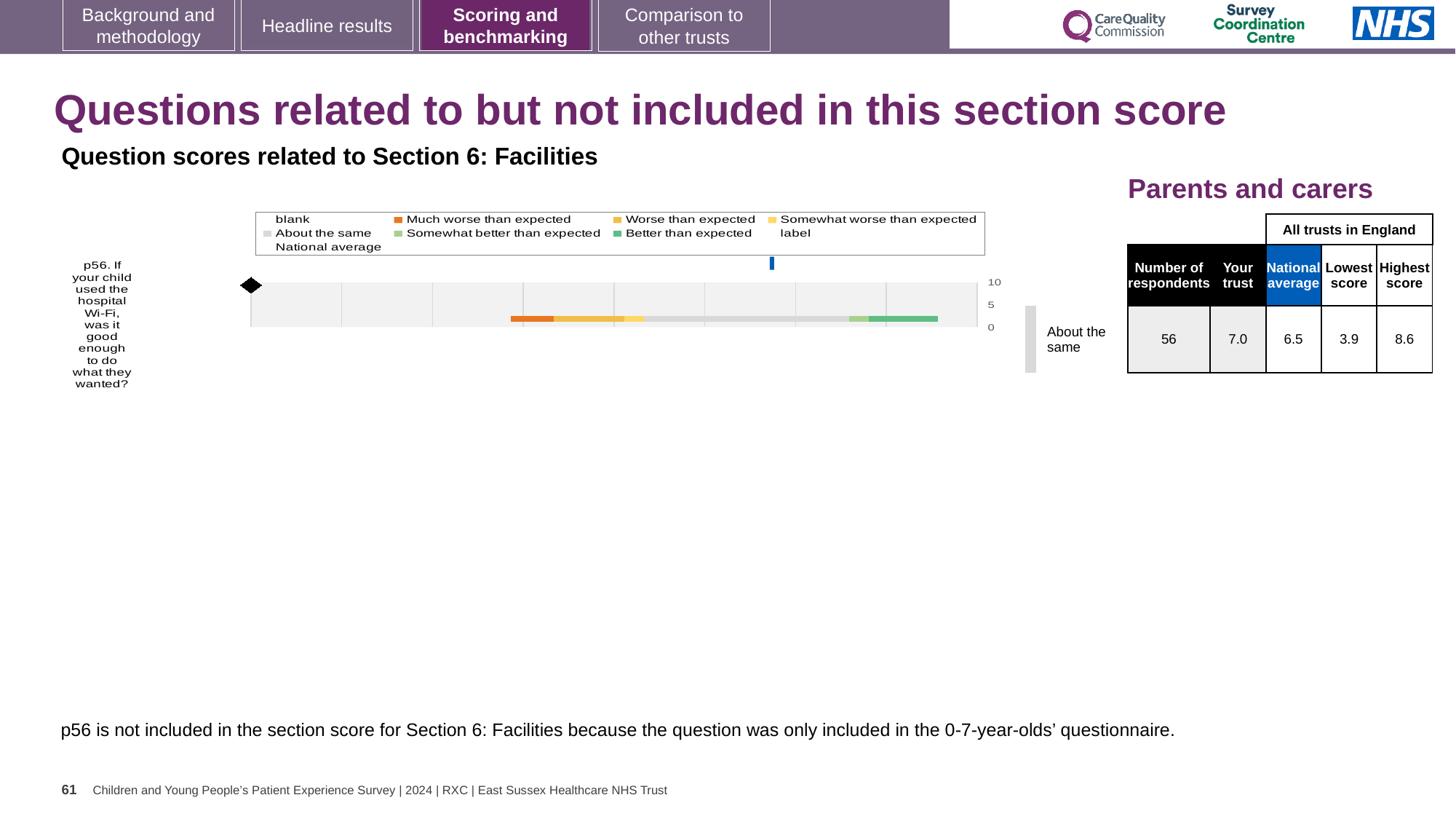
In the table beside the chart, what is the lowest score among all trusts in England for p56? 3.9 What is the highest value shown on the chart's axis? 10 How many entries does the chart legend list? 9 In the table beside the chart, what is the national average score for p56? 6.5 How many questions are plotted in the chart? 1 In the table beside the chart, what is the 'Your trust' score for p56? 7.0 What kind of chart is used to show the p56 question score? bar chart For p56, which is larger: the 'Your trust' score or the national average? Your trust What is the difference between the highest score and the lowest score for p56 in the table beside the chart? 4.7 In the table beside the chart, how many respondents answered p56? 56 In the table beside the chart, what is the highest score among all trusts in England for p56? 8.6 What colour represents 'Much worse than expected' in the chart legend? orange